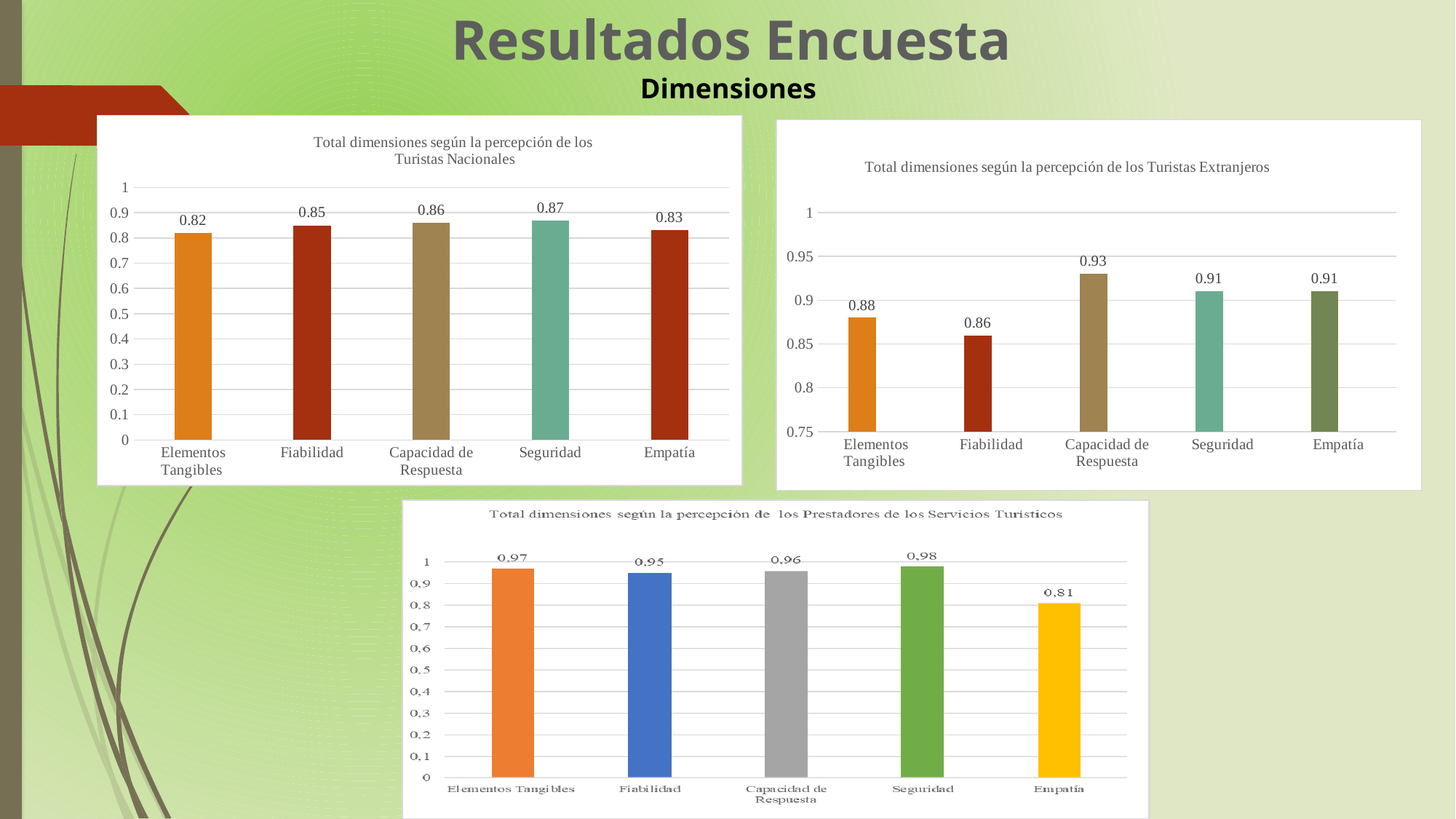
In the chart 'Total dimensiones según la percepción de los Prestadores de los Servicios Turísticos', what is the value for Empatía? 0,81 In the chart 'Total dimensiones según la percepción de los Turistas Nacionales', which category has the lowest value? Elementos Tangibles In the chart 'Total dimensiones según la percepción de los Turistas Nacionales', what is the difference between Seguridad and Elementos Tangibles? 0.05 In the chart 'Total dimensiones según la percepción de los Turistas Extranjeros', what is the value for Capacidad de Respuesta? 0.93 In the chart 'Total dimensiones según la percepción de los Prestadores de los Servicios Turísticos', what is the difference between Seguridad and Empatía? 0,17 What kind of chart is 'Total dimensiones según la percepción de los Turistas Extranjeros'? Bar chart In the chart 'Total dimensiones según la percepción de los Turistas Extranjeros', which is larger, Elementos Tangibles or Fiabilidad? Elementos Tangibles In the chart 'Total dimensiones según la percepción de los Turistas Nacionales', what is the value for Seguridad? 0.87 In the chart 'Total dimensiones según la percepción de los Prestadores de los Servicios Turísticos', which category has the highest value? Seguridad In the chart 'Total dimensiones según la percepción de los Turistas Extranjeros', which category has the lowest value? Fiabilidad How many categories are shown in the chart 'Total dimensiones según la percepción de los Turistas Nacionales'? 5 How many charts are shown on the slide? 3